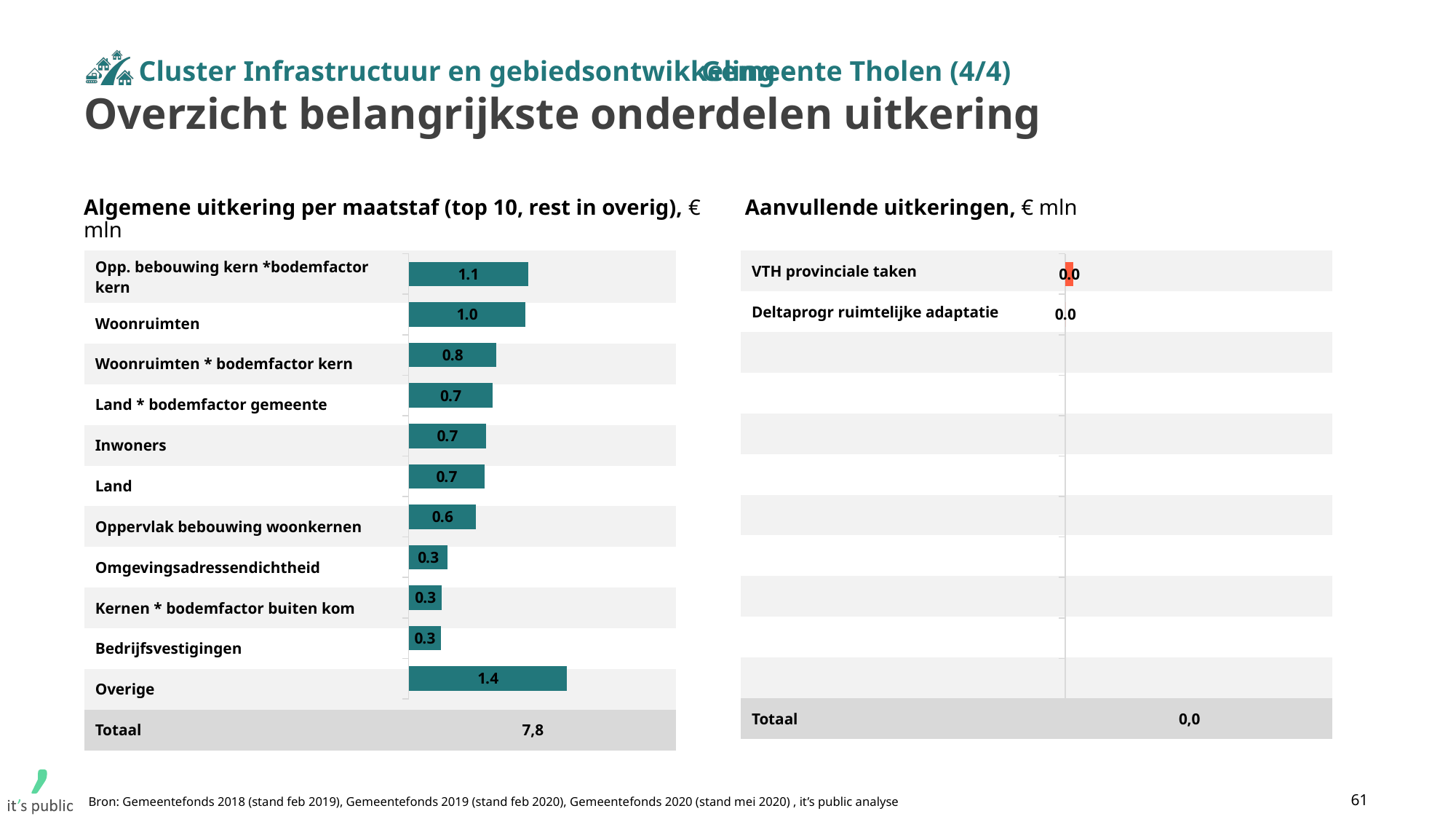
What unit is stated in the title of the 'Aanvullende uitkeringen' chart? € mln In the 'Aanvullende uitkeringen' chart, what is the value for VTH provinciale taken? 0.0 In the 'Algemene uitkering per maatstaf' chart, what is the value for Oppervlak bebouwing woonkernen? 0.6 In the 'Algemene uitkering per maatstaf' chart, which category has the highest value? Overige How many categories (bars) are shown in the 'Algemene uitkering per maatstaf' chart? 11 In the 'Algemene uitkering per maatstaf' chart, what is the value for Omgevingsadressendichtheid? 0.3 What is the Totaal shown under the 'Algemene uitkering per maatstaf' chart? 7,8 In the 'Algemene uitkering per maatstaf' chart, what is the difference between Overige and Woonruimten? 0.4 What kind of chart is the 'Algemene uitkering per maatstaf' chart? Bar chart In the 'Algemene uitkering per maatstaf' chart, what is the value for Woonruimten? 1.0 How many categories are listed in the 'Aanvullende uitkeringen' chart? 2 In the 'Algemene uitkering per maatstaf' chart, which is larger: Woonruimten * bodemfactor kern or Land * bodemfactor gemeente? Woonruimten * bodemfactor kern